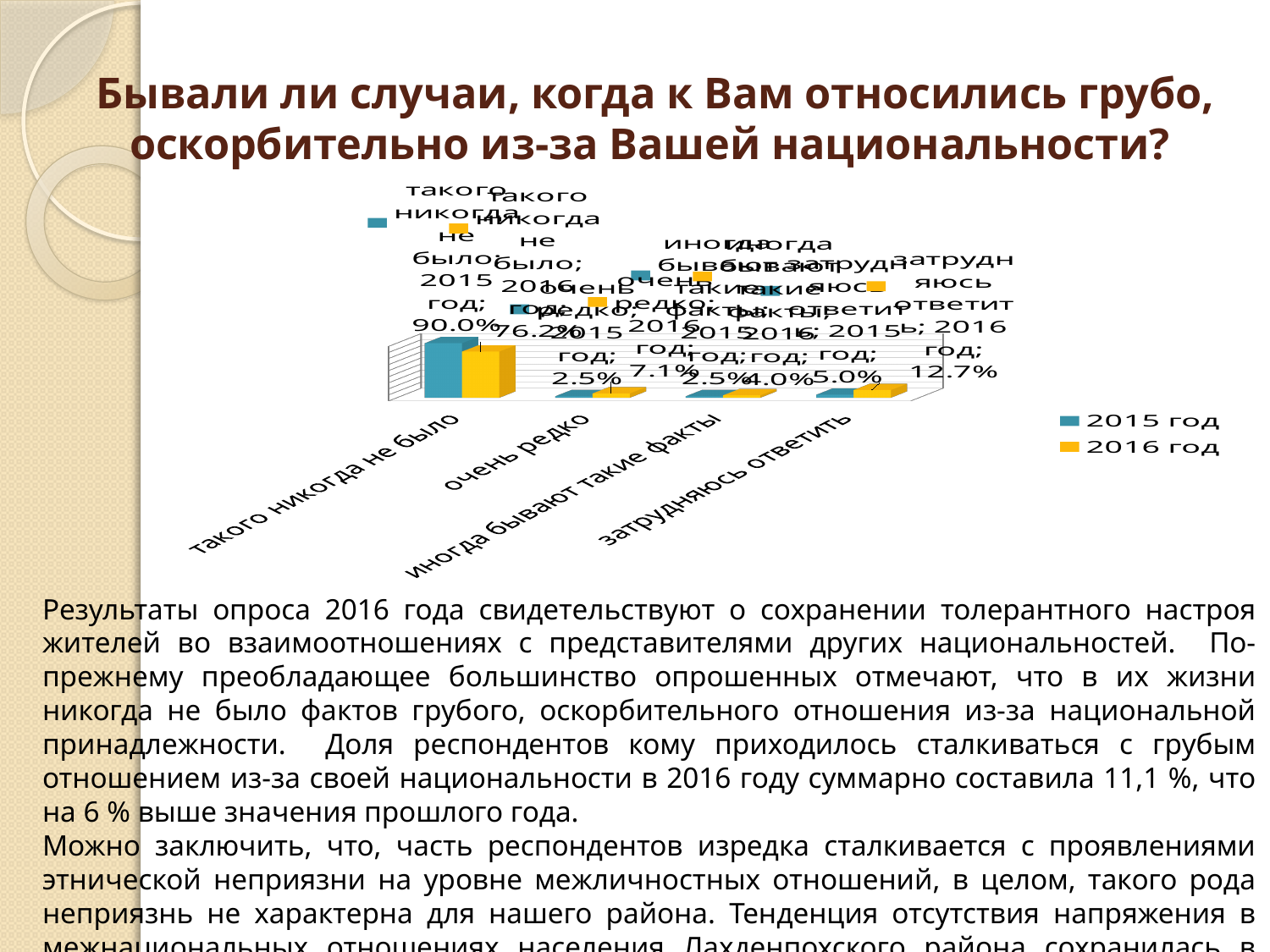
Which colour represents the 2016 год series in the chart? yellow Which category has the lowest value in the 2016 год series? иногда бывают такие факты Which category has the highest value in the 2015 год series? такого никогда не было How many series does the chart legend list? 2 What is the value for "очень редко" in the 2016 год series? 7.1% What is the difference between the 2015 год and 2016 год values for "такого никогда не было"? 13.8% Which is larger for "затрудняюсь ответить": the 2015 год value or the 2016 год value? 2016 год What type of chart is shown on the slide? bar chart How many categories are shown on the x axis of the chart? 4 What is the value for "такого никогда не было" in the 2015 год series? 90.0% What is the value for "такого никогда не было" in the 2016 год series? 76.2% What is the value for "затрудняюсь ответить" in the 2016 год series? 12.7%